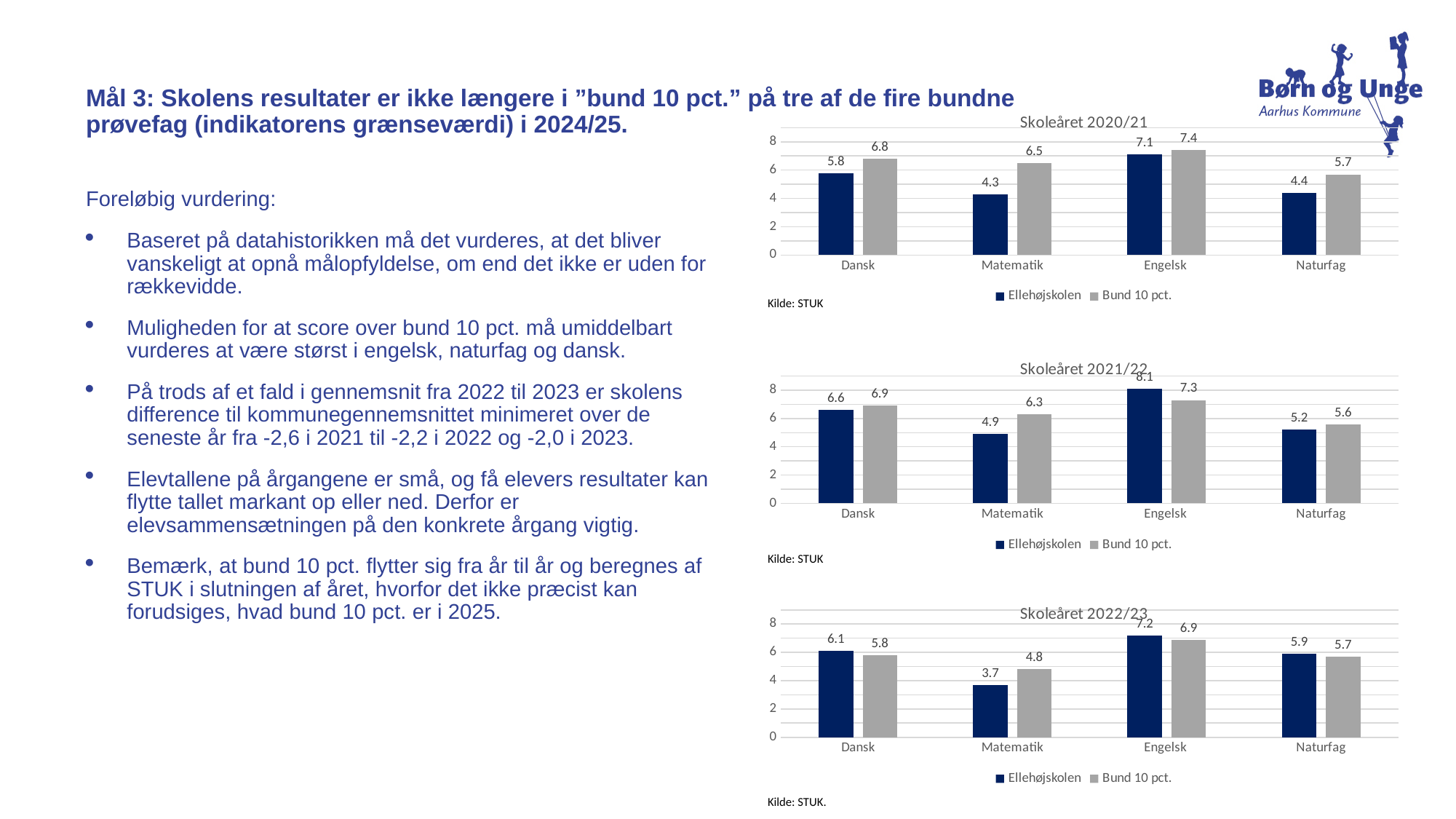
In the 'Skoleåret 2022/23' chart, which is larger in Naturfag: Ellehøjskolen or Bund 10 pct.? Ellehøjskolen What kind of chart is the 'Skoleåret 2021/22' chart? Bar chart In the 'Skoleåret 2020/21' chart, what is the value for Bund 10 pct. in Engelsk? 7.4 How many subject categories are shown in the 'Skoleåret 2022/23' chart? 4 In the 'Skoleåret 2022/23' chart, what is the value for Ellehøjskolen in Dansk? 6.1 In the 'Skoleåret 2022/23' chart, which subject has the lowest value for Ellehøjskolen? Matematik In the 'Skoleåret 2021/22' chart, what is the difference between Bund 10 pct. and Ellehøjskolen in Matematik? 1.4 In the 'Skoleåret 2020/21' chart, what is the value for Ellehøjskolen in Matematik? 4.3 In the 'Skoleåret 2021/22' chart, what is the value for Ellehøjskolen in Engelsk? 8.1 How many series does the legend list in the 'Skoleåret 2020/21' chart? 2 In the 'Skoleåret 2021/22' chart, which subject has the highest value for Bund 10 pct.? Engelsk In the 'Skoleåret 2020/21' chart, which subject has the lowest value for Ellehøjskolen? Matematik